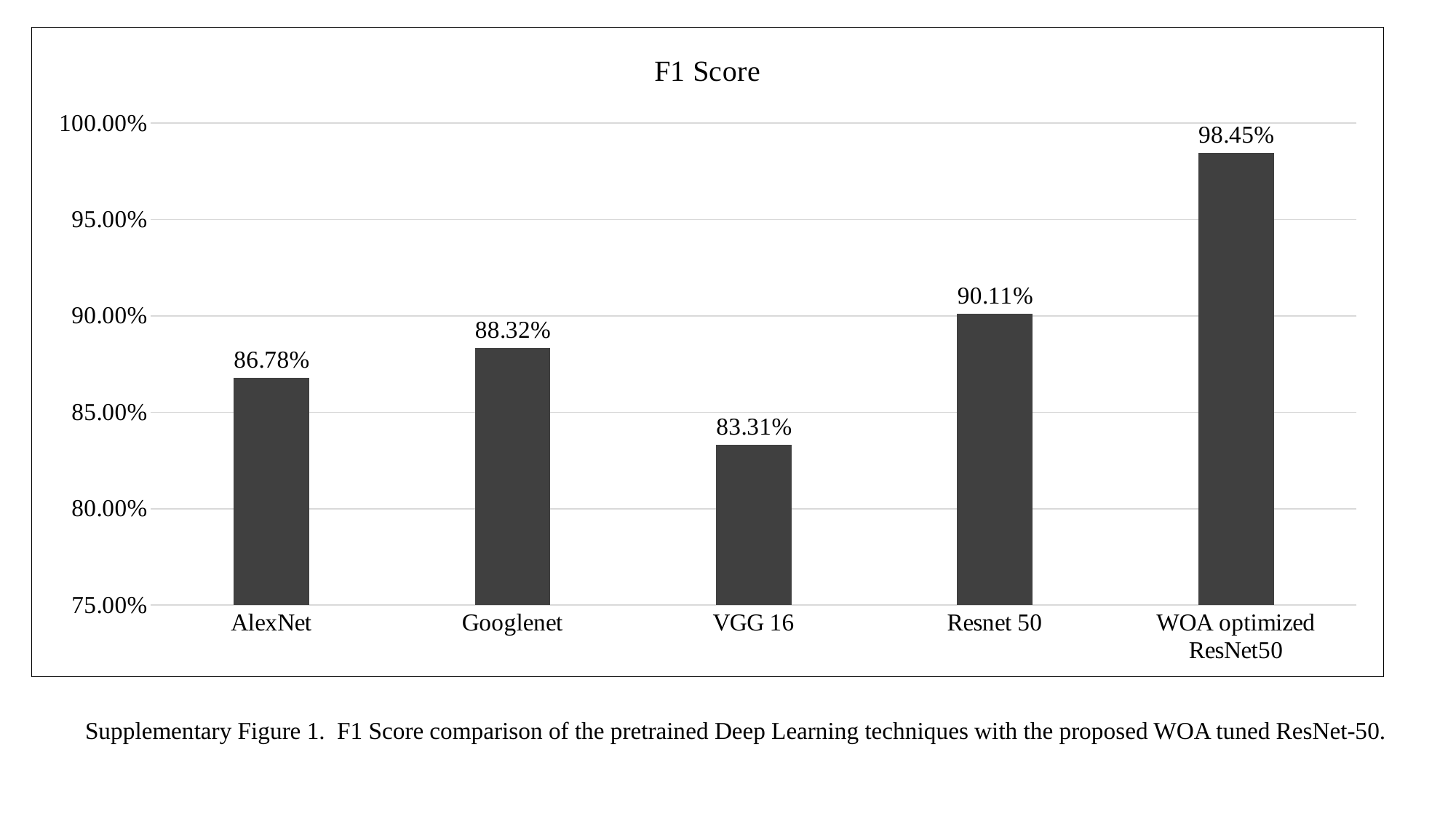
What is the F1 Score for VGG 16? 83.31% What is the F1 Score for WOA optimized ResNet50? 98.45% What is the F1 Score for AlexNet? 86.78% Which model has the lowest F1 Score? VGG 16 Which has a higher F1 Score, Googlenet or Resnet 50? Resnet 50 What is the difference in F1 Score between WOA optimized ResNet50 and Resnet 50? 8.34% How many models are shown on the chart? 5 Is the F1 Score for VGG 16 greater or less than 85.00%? less What is the difference in F1 Score between Googlenet and AlexNet? 1.54% What is the title of the chart? F1 Score Which model has the highest F1 Score? WOA optimized ResNet50 What kind of chart is shown on the slide? bar chart